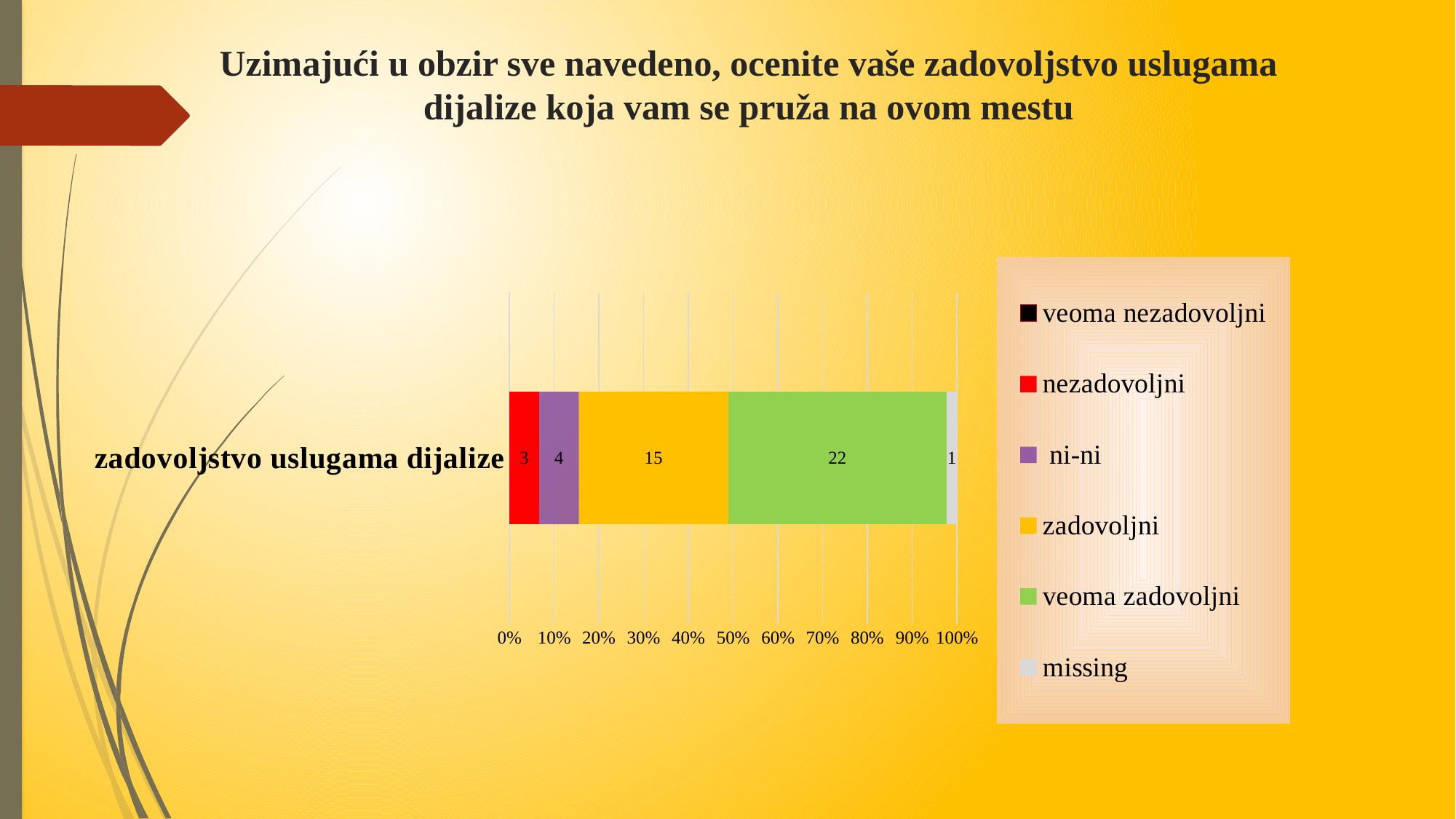
Which is larger, the 'ni-ni' value or the 'nezadovoljni' value? ni-ni What colour represents 'veoma zadovoljni' in the chart? green What is the value of the 'nezadovoljni' segment in the bar? 3 What kind of chart is shown on the slide? stacked bar chart What is the value of the 'ni-ni' segment in the bar? 4 How many series does the legend list? 6 What is the difference between the 'veoma zadovoljni' and 'zadovoljni' values? 7 What is the value of the 'missing' segment in the bar? 1 Which labelled series has the smallest value in the bar? missing What is the value of the 'zadovoljni' segment in the bar? 15 What is the value of the 'veoma zadovoljni' segment in the bar? 22 Which series has the largest value in the bar? veoma zadovoljni